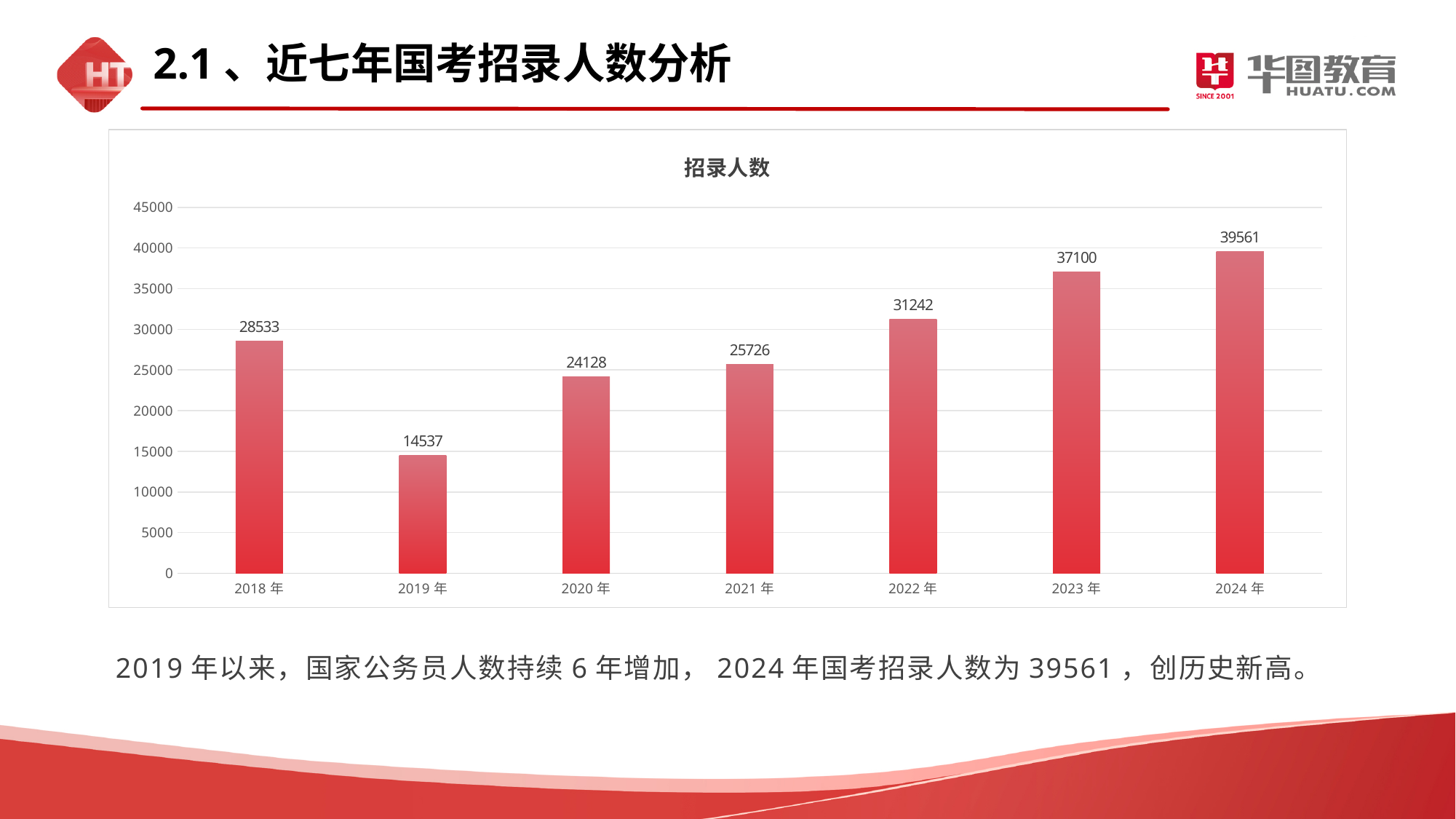
Is the value for 2020 年 greater or less than 25000? less What kind of chart is shown on the slide? bar chart What is the value for 2024 年 in the 招录人数 chart? 39561 Which year has the lowest value in the 招录人数 chart? 2019 年 Which year has the highest value in the 招录人数 chart? 2024 年 What is the difference between the values for 2024 年 and 2023 年? 2461 How many years are shown on the x axis of the chart? 7 Do the values rise or fall from 2019 年 to 2024 年? rise What is the difference between the values for 2018 年 and 2019 年? 13996 What is the value for 2022 年 in the 招录人数 chart? 31242 What is the value for 2019 年 in the 招录人数 chart? 14537 Which is larger, the value for 2018 年 or the value for 2021 年? 2018 年